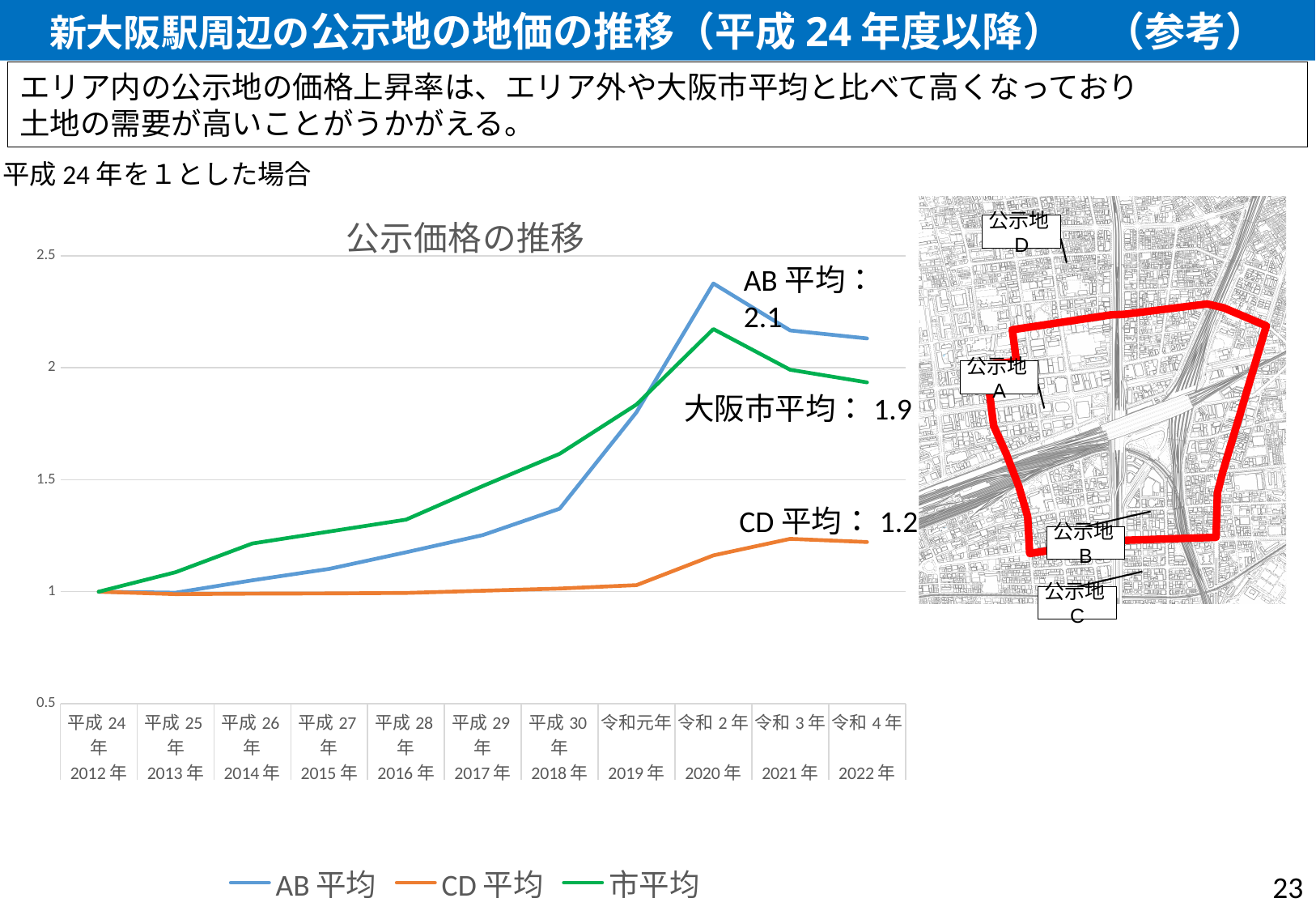
How many years (data points) are shown along the x axis of the chart? 11 What kind of chart is shown on the slide? line chart In 平成30年 (2018年), which is larger: AB平均 or 市平均? 市平均 What value is annotated for 大阪市平均 at the end of the chart? 1.9 Which series has the lowest value in 令和4年 (2022年)? CD平均 Is the value for CD平均 in 令和元年 (2019年) greater or less than 1.5? less Is the value for AB平均 in 令和2年 (2020年) greater or less than 2? greater What value is annotated for AB平均 at the end of the chart? 2.1 What value is annotated for CD平均 at the end of the chart? 1.2 Which series has the highest value in 令和4年 (2022年)? AB平均 How many series does the chart legend list? 3 What is the title of the chart? 公示価格の推移